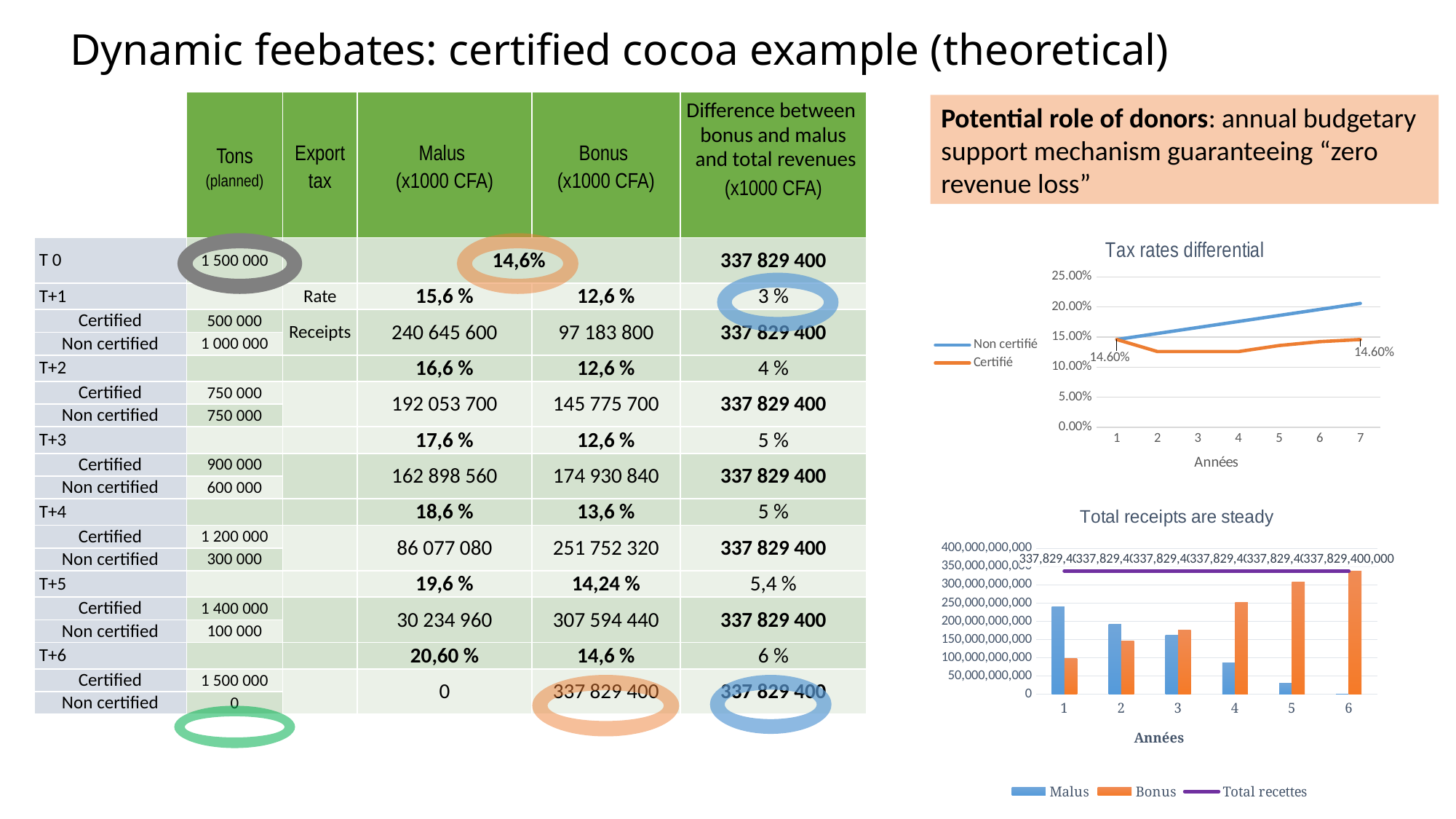
In the "Tax rates differential" chart, what is the labelled value of the Certifié series at year 7? 14.60% In the "Tax rates differential" chart, does the Non certifié line rise or fall from year 1 to year 7? rises In the "Total receipts are steady" chart, what is the labelled value of Total recettes at year 6? 337,829,400,000 How many series does the legend of the "Tax rates differential" chart list? 2 In the "Tax rates differential" chart, which series is higher at year 7, Non certifié or Certifié? Non certifié What kind of chart is the "Tax rates differential" chart? line chart In the "Total receipts are steady" chart, which year has the highest Bonus bar? 6 How many series does the legend of the "Total receipts are steady" chart list? 3 In the "Total receipts are steady" chart, do the Malus bars rise or fall from year 1 to year 6? fall In the "Tax rates differential" chart, is the Non certifié value at year 7 greater or less than 20.00%? greater In the "Total receipts are steady" chart, is the Malus value for year 1 greater or less than 200,000,000,000? greater How many years are shown on the x axis of the "Total receipts are steady" chart? 6